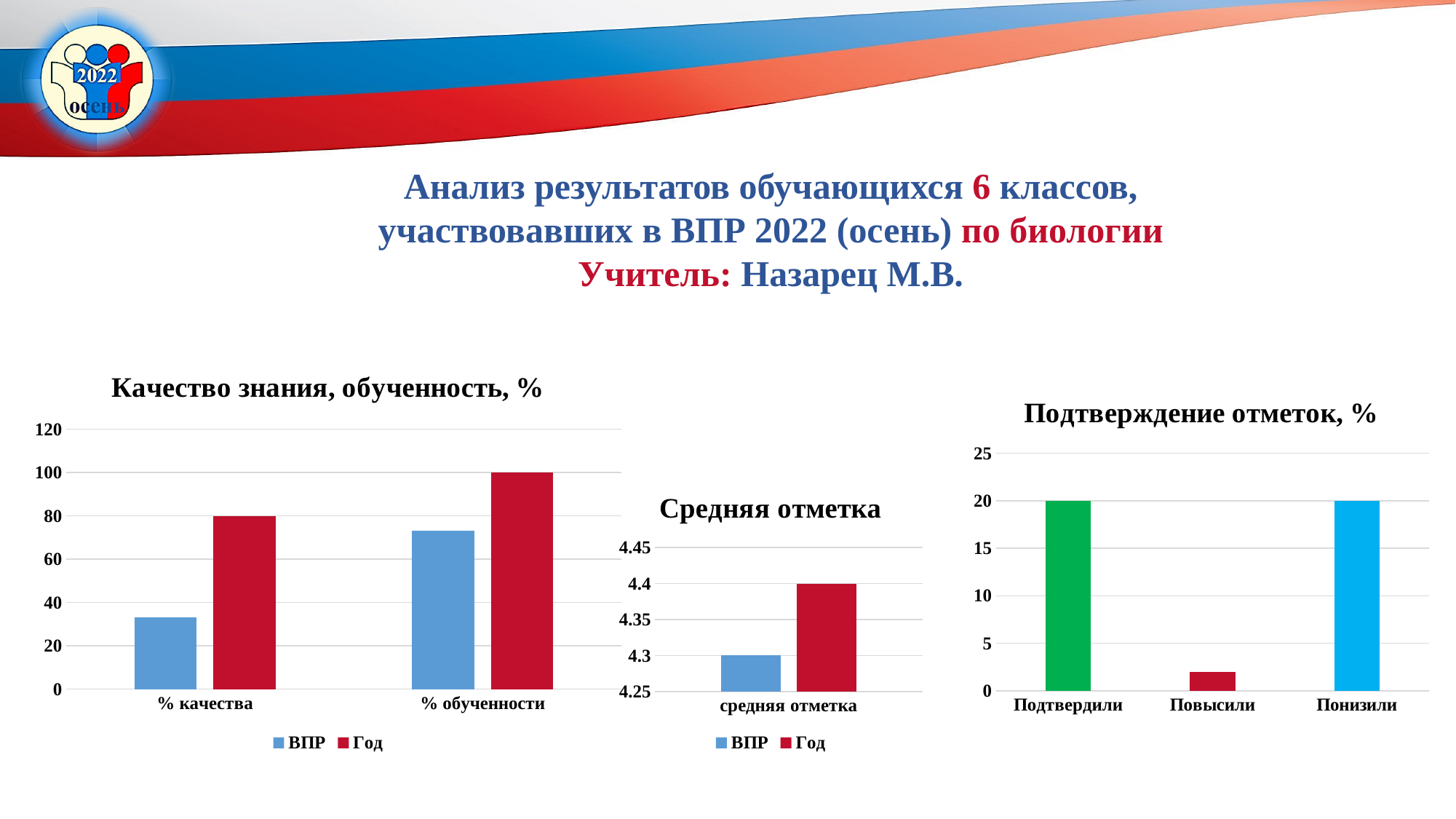
In the chart titled "Качество знания, обученность, %", is the ВПР value for % качества greater or less than 40? less In the chart titled "Качество знания, обученность, %", is the ВПР value for % обученности greater or less than 60? greater How many series does the legend of the chart titled "Качество знания, обученность, %" list? 2 In the chart titled "Средняя отметка", what is the value of the Год series? 4.4 In the chart titled "Подтверждение отметок, %", what is the value for Подтвердили? 20 In the chart titled "Подтверждение отметок, %", which category has the lowest value? Повысили In the chart titled "Качество знания, обученность, %", what is the value of the Год series for % качества? 80 In the chart titled "Средняя отметка", what is the difference between the Год value and the ВПР value? 0.1 In the chart titled "Качество знания, обученность, %", what is the value of the Год series for % обученности? 100 In the chart titled "Средняя отметка", what is the value of the ВПР series? 4.3 What kind of chart is the chart titled "Подтверждение отметок, %"? bar chart In the chart titled "Качество знания, обученность, %", which series has the larger value for % качества, ВПР or Год? Год